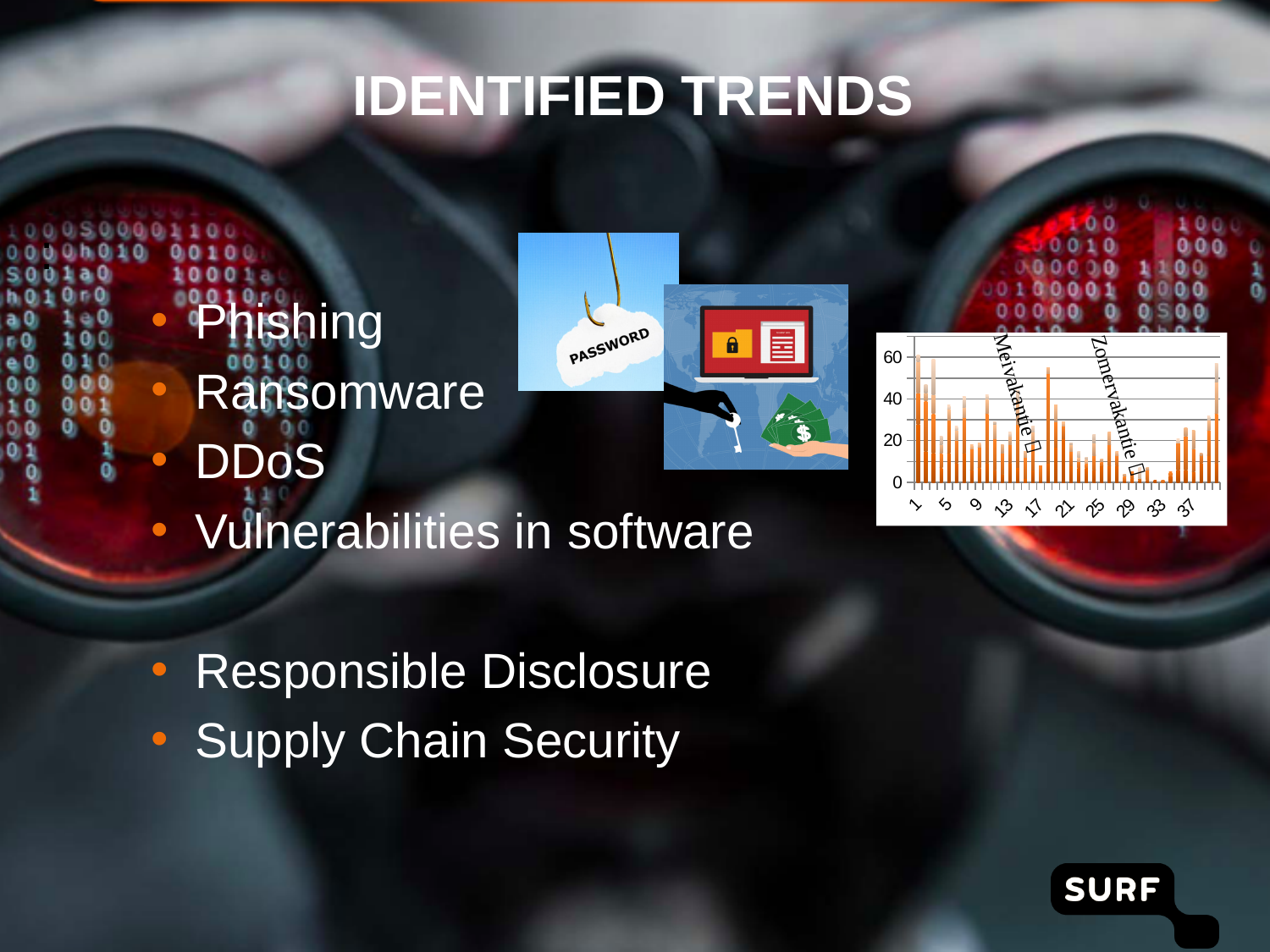
What kind of chart is shown on the right side of the slide? bar chart What is the highest value shown on the y axis of the chart? 60 Is the value for category 29 on the chart greater or less than 20? less What two annotations are written on the chart? Meivakantie and Zomervakantie What is the last label shown on the x axis of the chart? 37 Is the value for category 1 on the chart greater or less than 40? greater How many tick labels are shown on the x axis of the chart? 10 Is the value for category 33 on the chart greater or less than 20? less